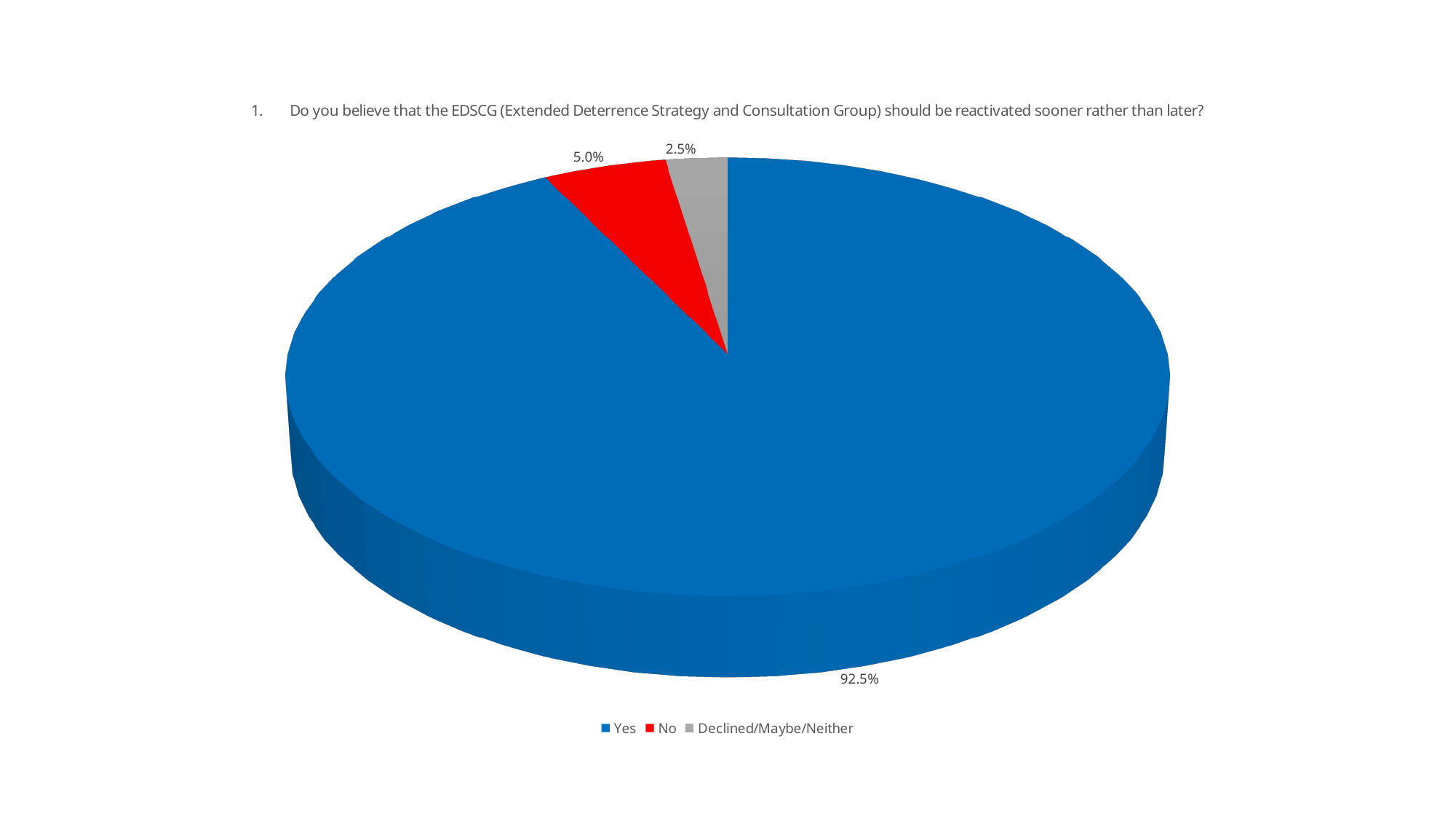
How many categories does the pie chart show? 3 What is the title of the chart? Do you believe that the EDSCG (Extended Deterrence Strategy and Consultation Group) should be reactivated sooner rather than later? What colour is the Yes slice of the pie? Blue Which response category has the largest share of the pie? Yes What kind of chart is shown on the slide? Pie chart Which is larger, the share for No or the share for Declined/Maybe/Neither? No What percentage of respondents answered No? 5.0% Which response category has the smallest share of the pie? Declined/Maybe/Neither What percentage of respondents are in the Declined/Maybe/Neither category? 2.5% What is the difference in percentage points between the No and Declined/Maybe/Neither shares? 2.5 What is the difference in percentage points between the Yes and No shares? 87.5 What percentage of respondents answered Yes? 92.5%